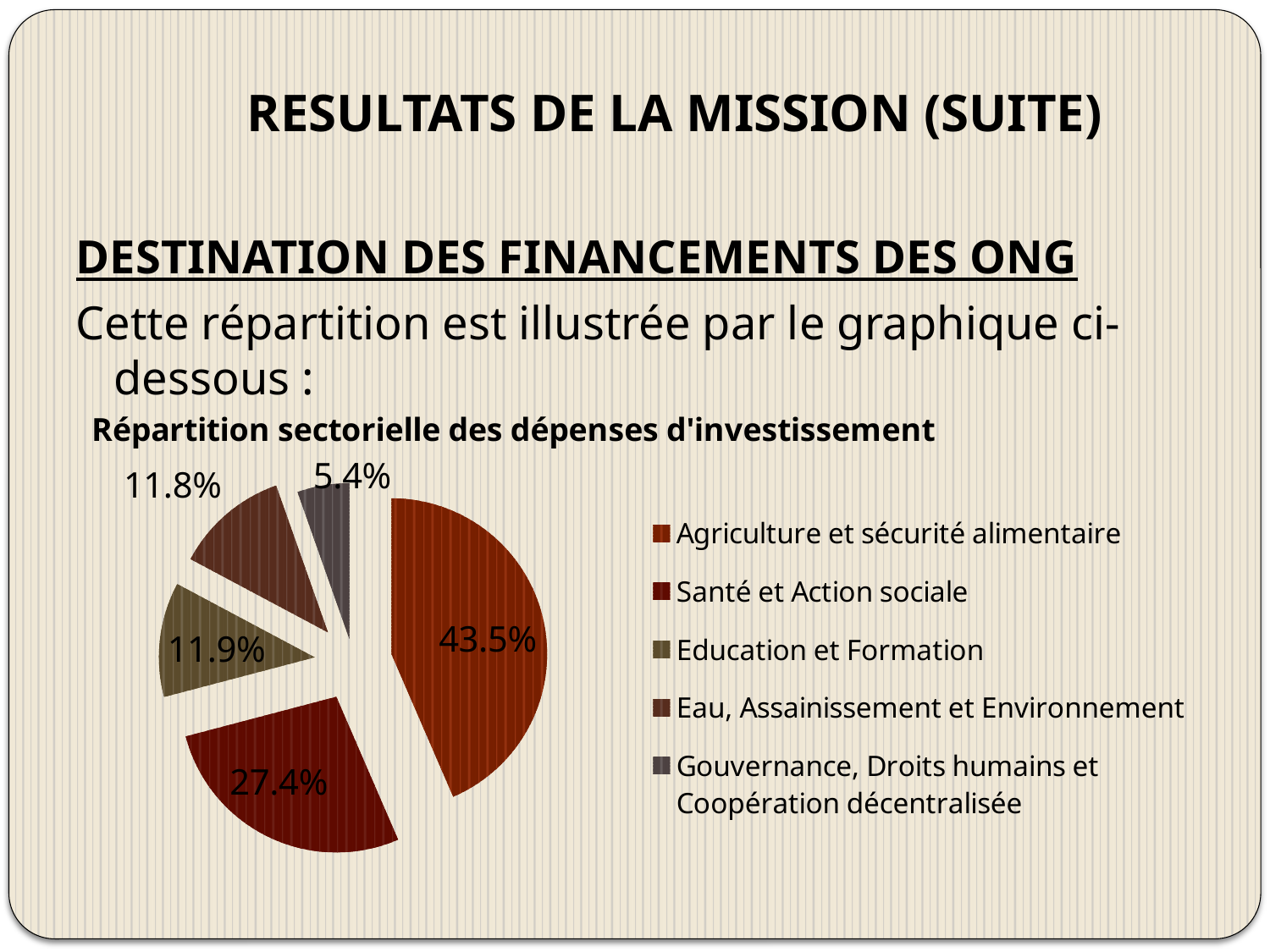
What is the title of the chart? Répartition sectorielle des dépenses d'investissement What percentage is shown for Education et Formation? 11.9% What is the value shown for Santé et Action sociale? 27.4% What is the difference in percentage points between Agriculture et sécurité alimentaire and Santé et Action sociale? 16.1 Which sector has the largest slice of the pie? Agriculture et sécurité alimentaire What share of the pie does Agriculture et sécurité alimentaire represent? 43.5% Which sector has the smallest slice of the pie? Gouvernance, Droits humains et Coopération décentralisée How many sectors are listed in the legend? 5 What kind of chart is shown on the slide? Pie chart What share is shown for Gouvernance, Droits humains et Coopération décentralisée? 5.4% What is the value for Eau, Assainissement et Environnement? 11.8% Which is larger: Santé et Action sociale or Education et Formation? Santé et Action sociale